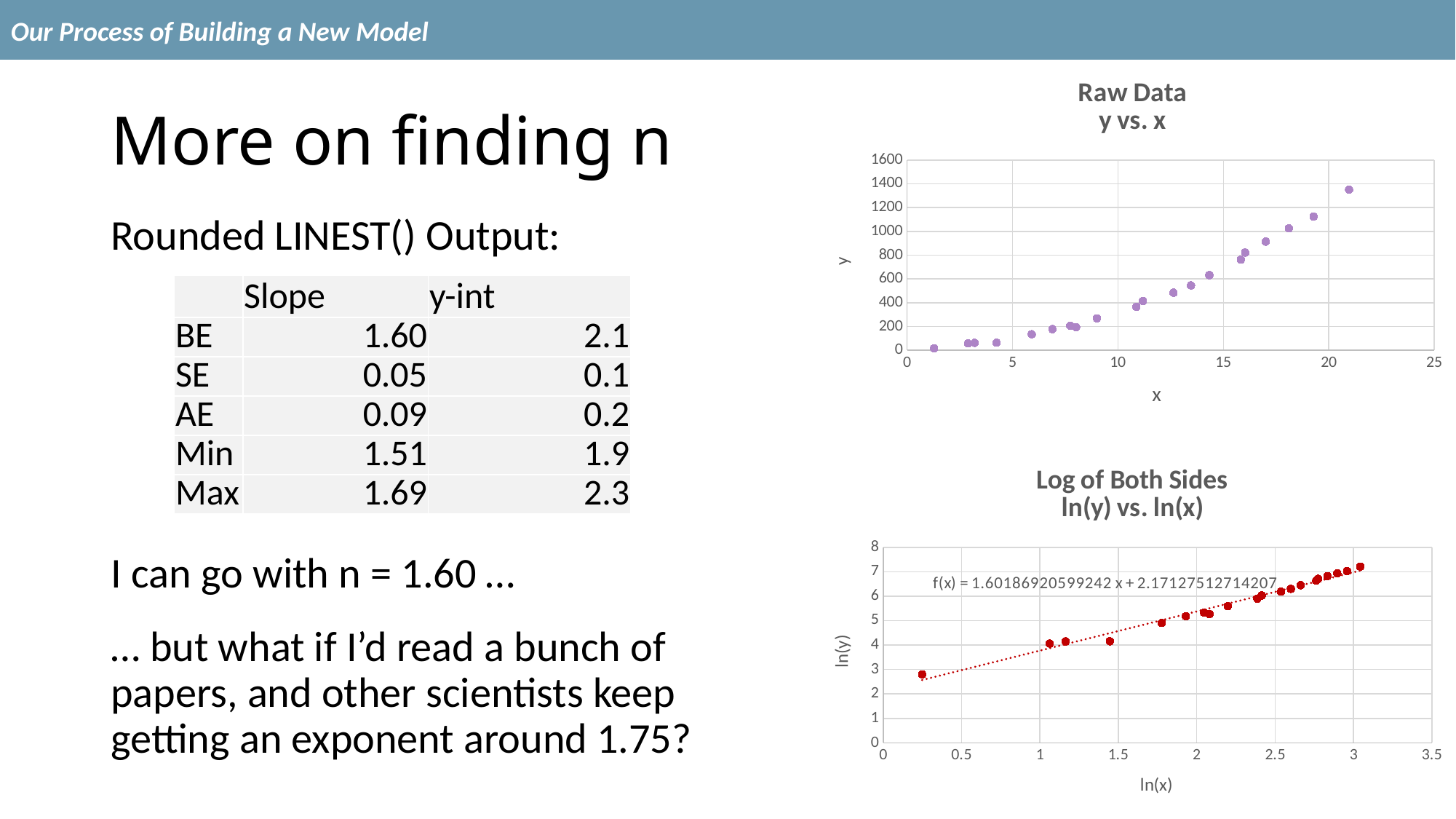
In the 'Log of Both Sides ln(y) vs. ln(x)' chart, is the highest ln(y) value greater or less than 6? greater In the 'Raw Data y vs. x' chart, is the largest y value greater or less than 1200? greater In the 'Log of Both Sides ln(y) vs. ln(x)' chart, do the ln(y) values rise or fall as ln(x) increases? rise In the 'Log of Both Sides ln(y) vs. ln(x)' chart, is the lowest ln(y) value greater or less than 3? less In the 'Log of Both Sides ln(y) vs. ln(x)' chart, what is the intercept in the displayed trendline equation? 2.17127512714207 What is the x-axis label of the 'Log of Both Sides ln(y) vs. ln(x)' chart? ln(x) In the 'Raw Data y vs. x' chart, do the y values rise or fall as x increases? rise What kind of chart is the 'Log of Both Sides ln(y) vs. ln(x)' chart? scatter chart What kind of chart is the 'Raw Data y vs. x' chart? scatter chart What is the highest tick value on the y axis of the 'Raw Data y vs. x' chart? 1600 In the 'Log of Both Sides ln(y) vs. ln(x)' chart, what is the slope in the displayed trendline equation? 1.60186920599242